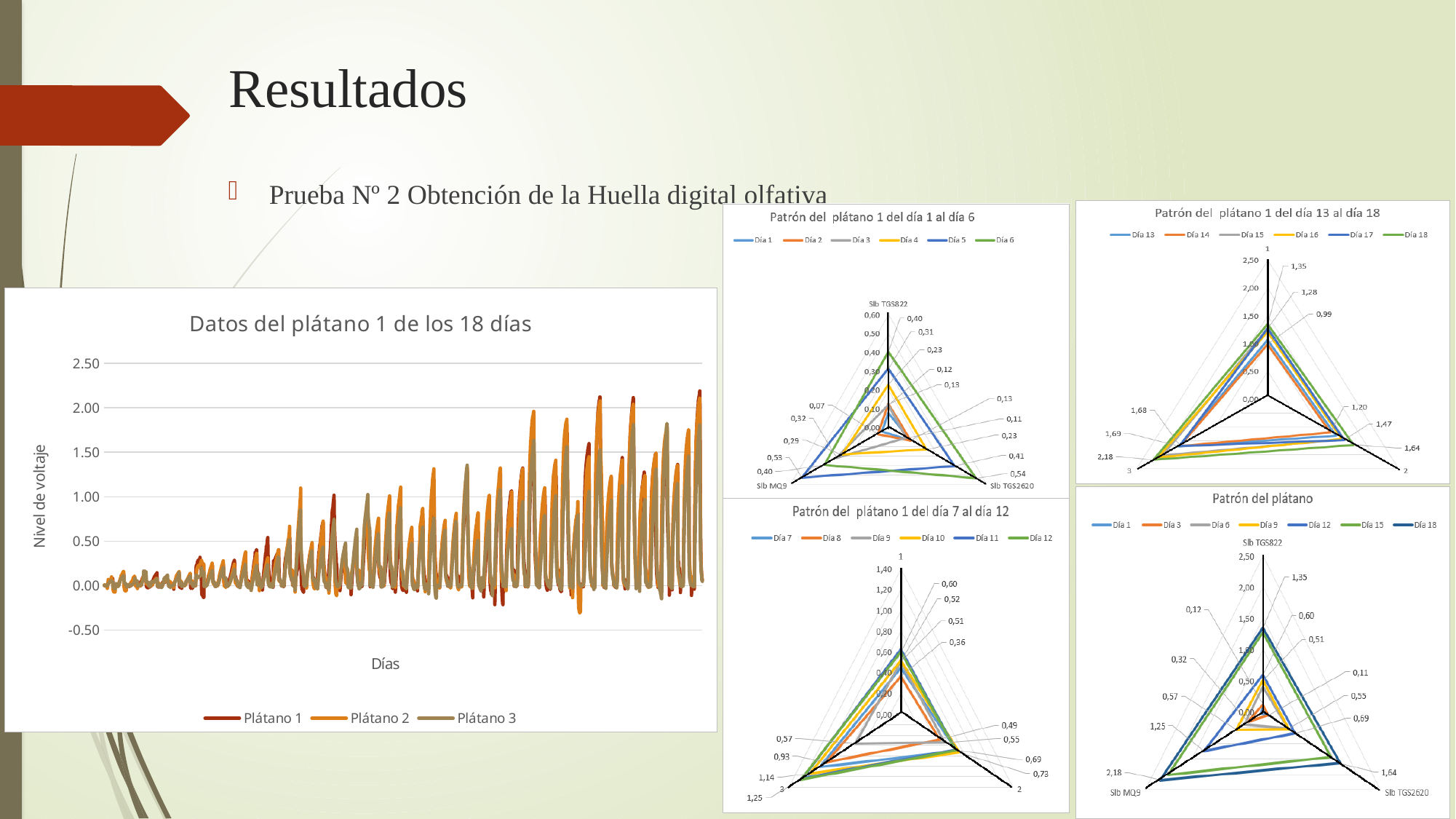
How many axes (categories) does the radar chart 'Patrón del plátano 1 del día 7 al día 12' have? 3 How many series does the legend of 'Datos del plátano 1 de los 18 días' list? 3 How many series does the legend of 'Patrón del plátano 1 del día 1 al día 6' list? 6 In 'Datos del plátano 1 de los 18 días', do the voltage peaks generally rise or fall as the days progress? rise What kind of chart is 'Datos del plátano 1 de los 18 días'? line chart What kind of chart is 'Patrón del plátano 1 del día 1 al día 6'? radar chart What is the highest tick value shown on the y axis of 'Datos del plátano 1 de los 18 días'? 2.50 What is the y-axis label of the chart 'Datos del plátano 1 de los 18 días'? Nivel de voltaje How many series does the legend of 'Patrón del plátano 1 del día 13 al día 18' list? 6 Which series are listed in the legend of 'Patrón del plátano 1 del día 7 al día 12'? Día 7, Día 8, Día 9, Día 10, Día 11, Día 12